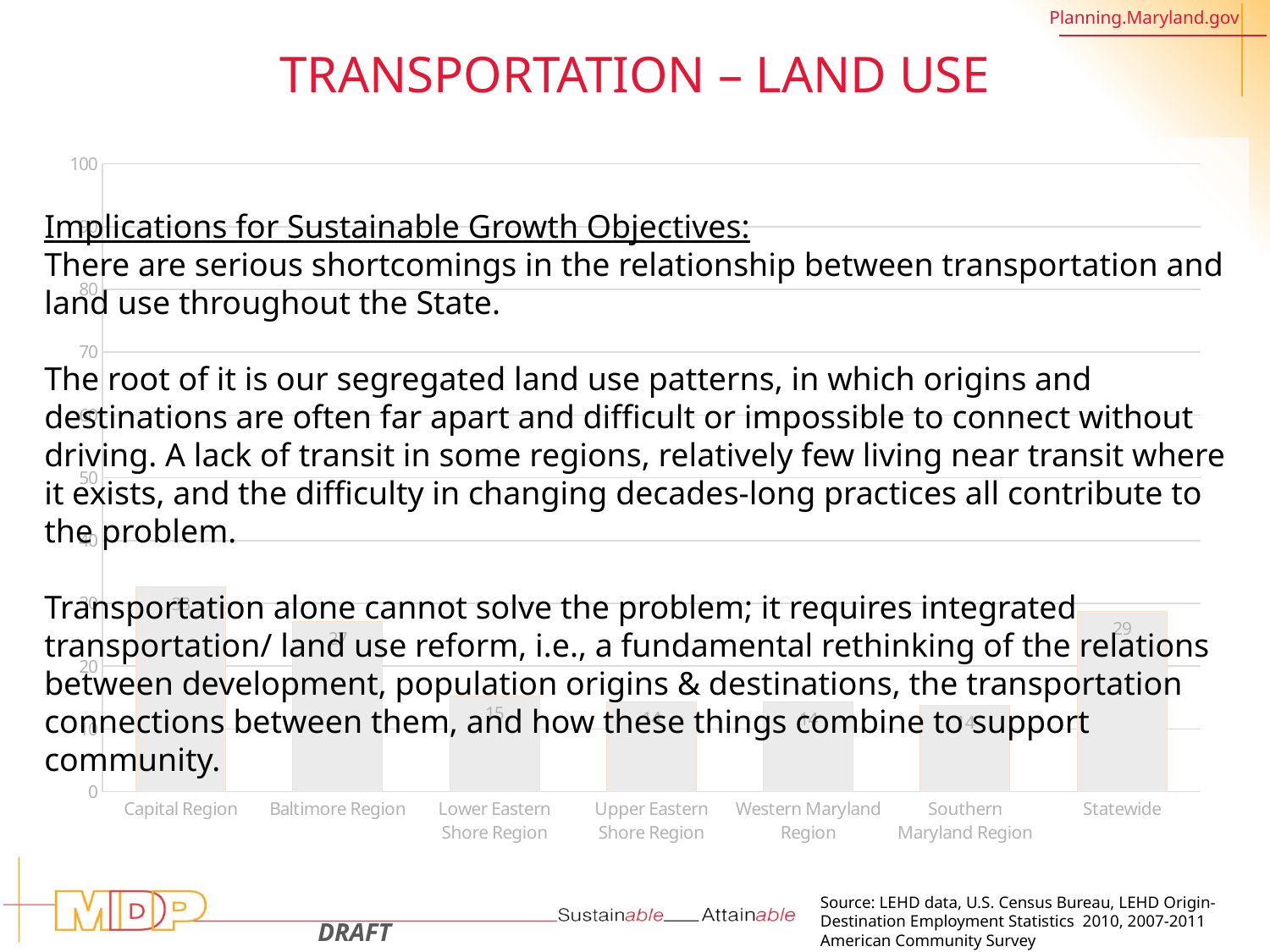
How many regions (categories) are plotted on the x axis of the chart? 7 What is the Statewide value? 29 What is the value for the Lower Eastern Shore Region? 15 What kind of chart is shown on the slide? bar chart Is the value for the Capital Region greater or less than 30? greater Which region has the highest bar in the chart? Capital Region What is the difference between the Baltimore Region value and the Lower Eastern Shore Region value? 12 Is the value for the Western Maryland Region greater or less than 20? less What is the difference between the Statewide value and the Baltimore Region value? 2 Which is larger, the Statewide value or the Baltimore Region value? Statewide What is the value for the Baltimore Region? 27